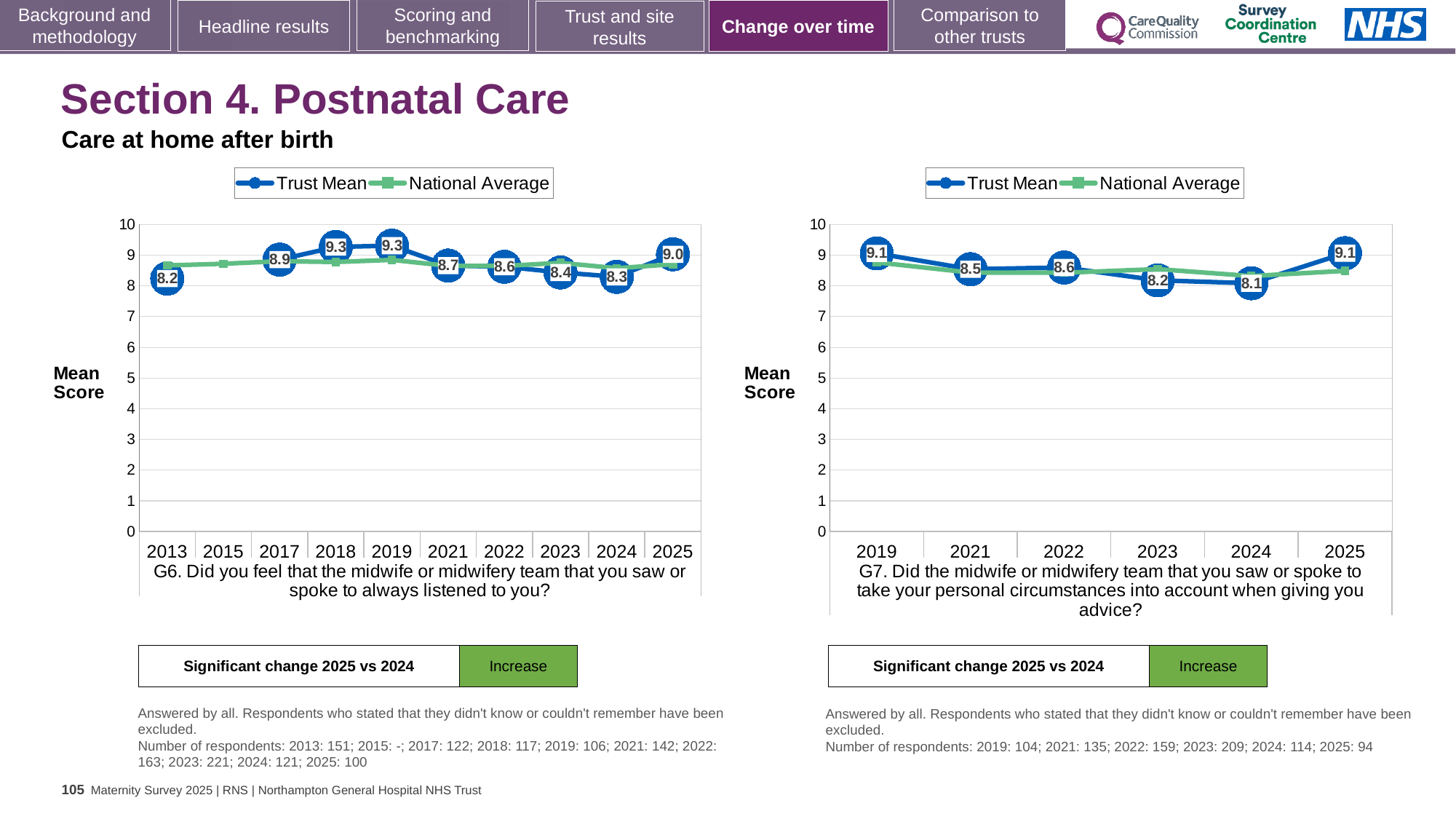
In the G7 chart on the right, what is the difference between the Trust Mean for 2025 and the Trust Mean for 2024? 1.0 In the G7 chart on the right, what is the Trust Mean for 2019? 9.1 How many years are shown on the x axis of the G7 chart on the right? 6 In the G7 chart on the right, what is the Trust Mean for 2024? 8.1 In the G7 chart on the right, is the National Average for 2025 greater or less than 8? greater How many series does the legend of the G6 chart on the left list? 2 In the G7 chart on the right, which year has the lowest Trust Mean? 2024 In the G6 chart on the left, what is the Trust Mean for 2025? 9.0 In the G6 chart on the left, which is larger: the Trust Mean for 2018 or the Trust Mean for 2021? 2018 In the G6 chart on the left, which year has the lowest Trust Mean? 2013 In the G6 chart on the left, what is the difference between the Trust Mean for 2025 and the Trust Mean for 2024? 0.7 In the G6 chart on the left, what is the Trust Mean for 2013? 8.2